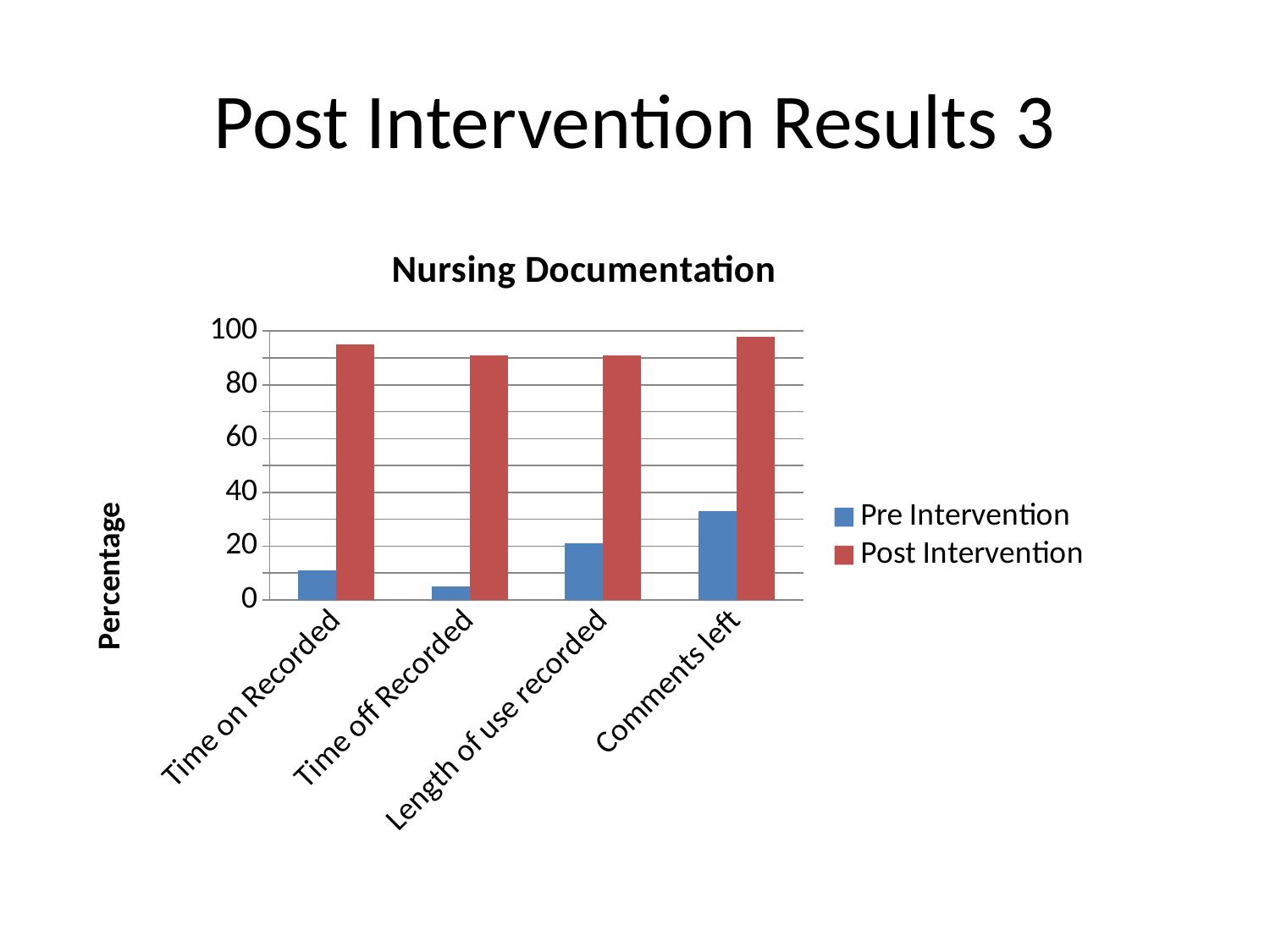
How many series does the legend of the Nursing Documentation chart list? 2 What kind of chart is shown under the title "Nursing Documentation"? bar chart Is the Pre Intervention value for Time on Recorded greater or less than 20? less Which is larger: the Pre Intervention value for Comments left or the Pre Intervention value for Time off Recorded? Comments left Which category has the lowest Pre Intervention value? Time off Recorded Which category has the highest Pre Intervention value? Comments left What is the label on the vertical axis of the Nursing Documentation chart? Percentage Which colour represents the Post Intervention series in the chart? red Is the Pre Intervention value for Comments left greater or less than 40? less Is the Post Intervention value for Time off Recorded greater or less than 80? greater For Time on Recorded, which is larger: the Pre Intervention value or the Post Intervention value? Post Intervention How many categories are shown on the x axis of the Nursing Documentation chart? 4